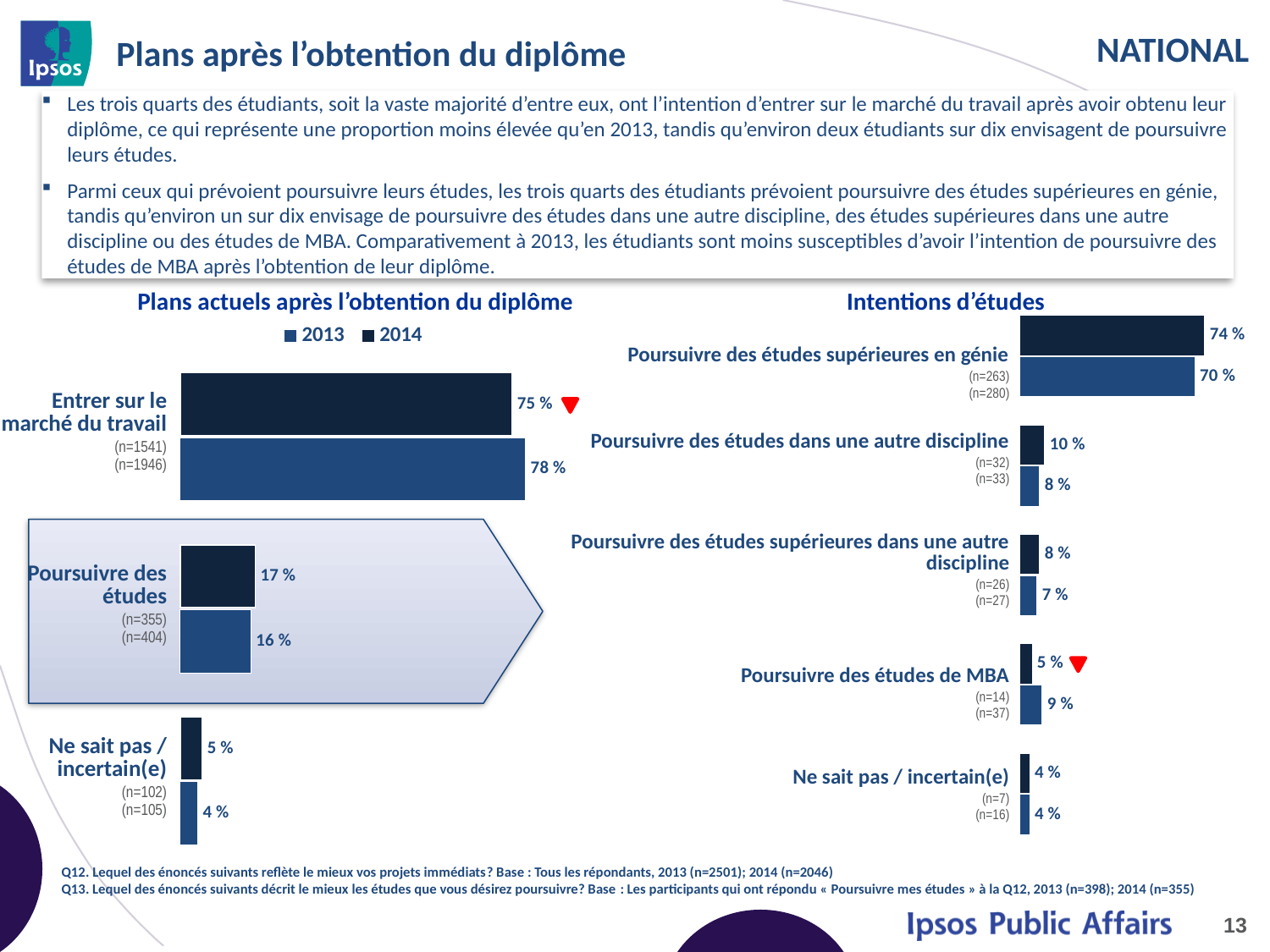
In the 'Plans actuels après l'obtention du diplôme' chart, what is the value of the top bar for 'Entrer sur le marché du travail'? 75 % How many categories are shown in the 'Intentions d'études' chart? 5 In the 'Intentions d'études' chart, for 'Poursuivre des études de MBA', is the top bar or the bottom bar larger? The bottom bar (9 %) How many categories are shown in the 'Plans actuels après l'obtention du diplôme' chart? 3 In the 'Plans actuels après l'obtention du diplôme' chart, what is the difference between the two bars for 'Entrer sur le marché du travail'? 3 percentage points In the 'Intentions d'études' chart, what is the value of the top bar for 'Poursuivre des études supérieures en génie'? 74 % How many series does the legend of the 'Plans actuels après l'obtention du diplôme' chart list? 2 What kind of chart is used for 'Plans actuels après l'obtention du diplôme'? Bar chart In the 'Intentions d'études' chart, which category has the highest values? Poursuivre des études supérieures en génie Which years are listed in the legend of the 'Plans actuels après l'obtention du diplôme' chart? 2013 and 2014 In the 'Plans actuels après l'obtention du diplôme' chart, what is the value of the bottom bar for 'Ne sait pas / incertain(e)'? 4 % In the 'Intentions d'études' chart, what is the value of the top bar for 'Poursuivre des études dans une autre discipline'? 10 %